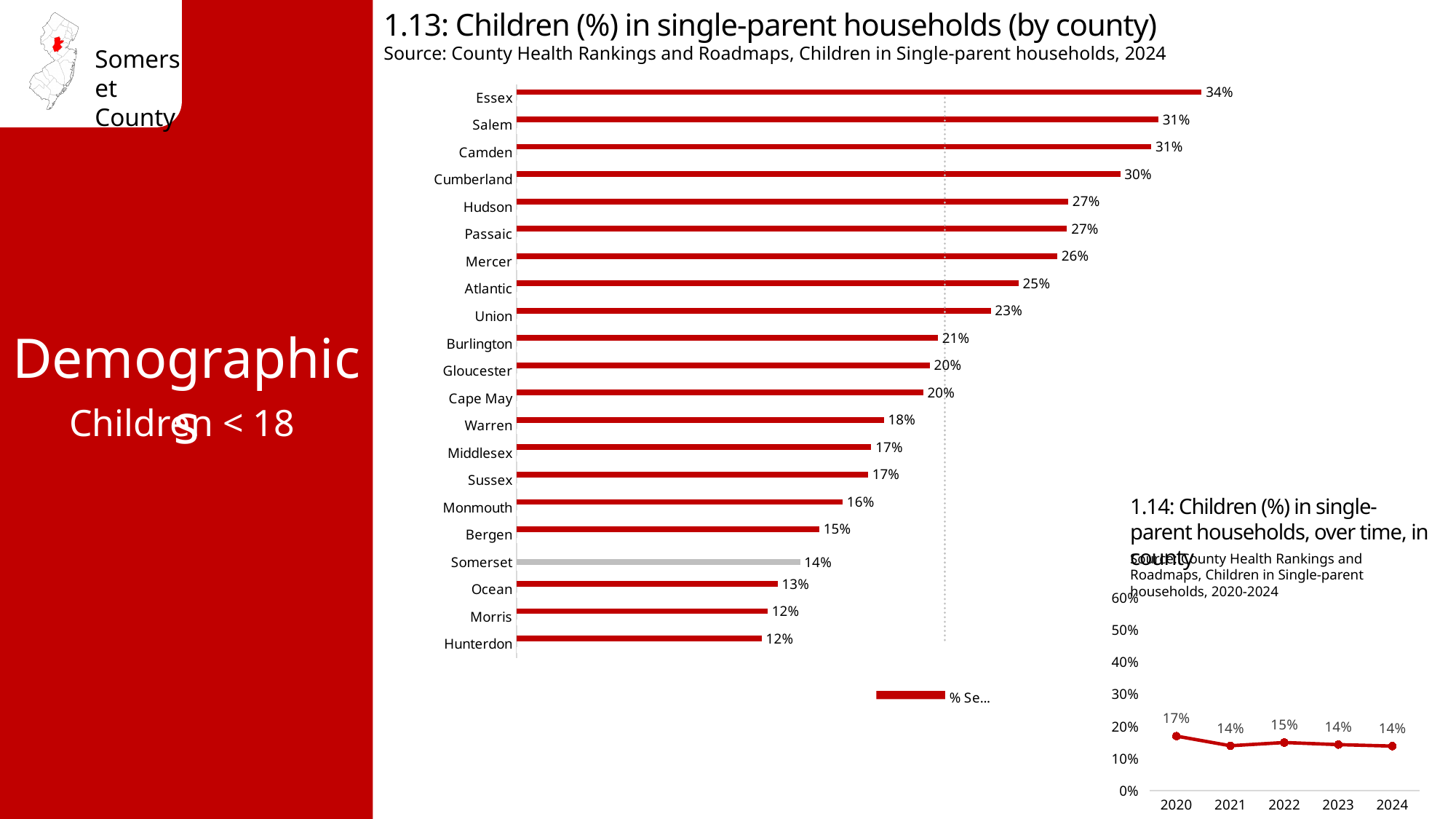
In chart 1.14, which year has the highest value? 2020 In chart 1.14 (children in single-parent households over time), what is the value for 2020? 17% In chart 1.13 (children in single-parent households by county), what is the value for Somerset? 14% In chart 1.13, what is the value for Cumberland? 30% In chart 1.14, what is the value for 2024? 14% In chart 1.13, which county has the highest percentage of children in single-parent households? Essex In chart 1.13, what is the difference between the values for Essex and Somerset? 20 percentage points In chart 1.14, how many years are plotted? 5 In chart 1.13, what is the value for Hudson? 27% What kind of chart is chart 1.13? Bar chart In chart 1.13, which county has a larger value, Union or Bergen? Union In chart 1.13, how many counties are shown? 21